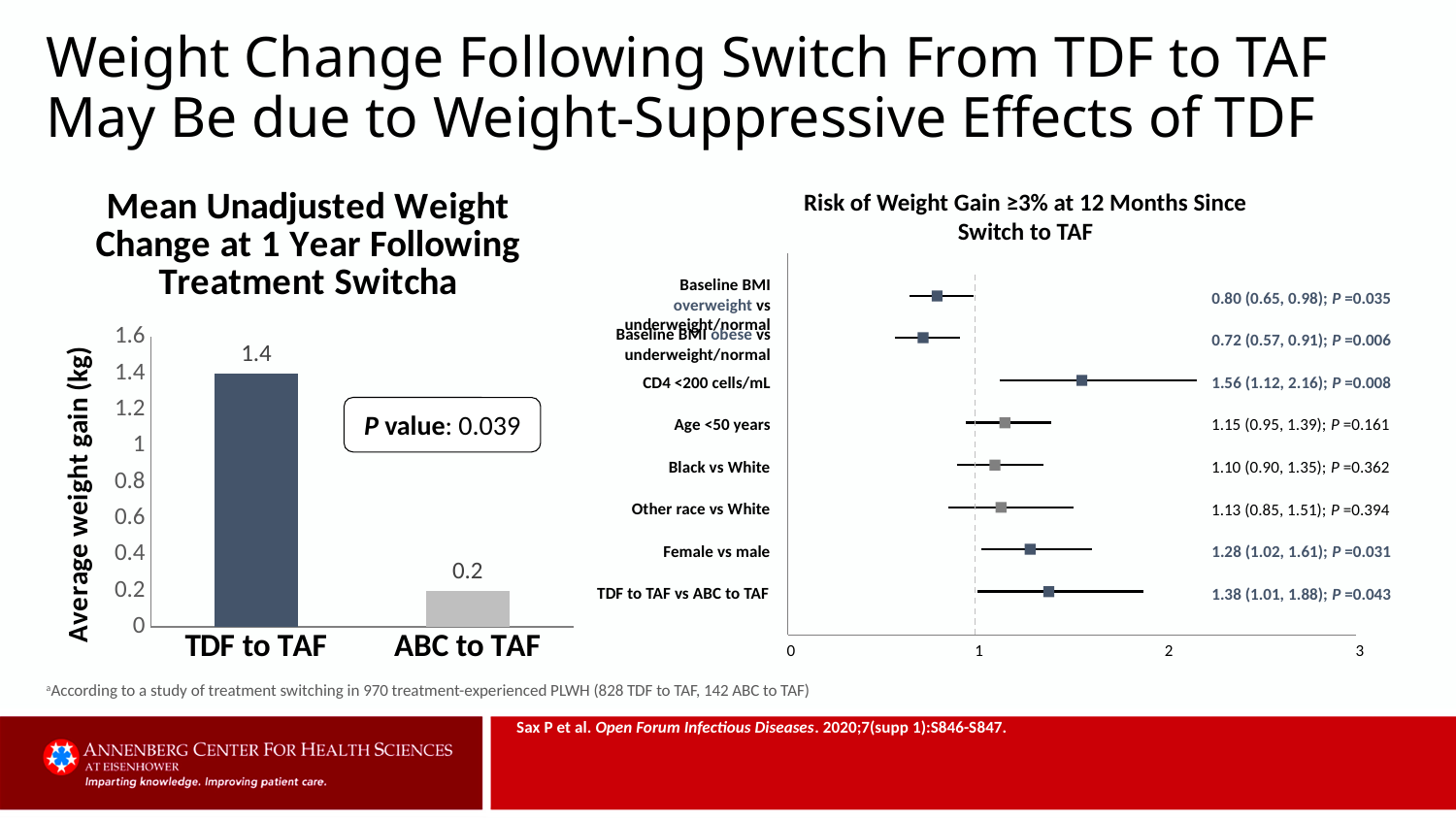
How many comparisons are plotted in the right chart (Risk of Weight Gain ≥3% at 12 Months Since Switch to TAF)? 8 In the right chart (Risk of Weight Gain ≥3% at 12 Months Since Switch to TAF), which comparison has the highest point estimate? CD4 <200 cells/mL In the left chart (Mean Unadjusted Weight Change at 1 Year Following Treatment Switch), what P value is shown? 0.039 In the left chart (Mean Unadjusted Weight Change at 1 Year Following Treatment Switch), which group has the higher average weight gain? TDF to TAF In the left chart (Mean Unadjusted Weight Change at 1 Year Following Treatment Switch), what is the difference in average weight gain between TDF to TAF and ABC to TAF? 1.2 In the right chart (Risk of Weight Gain ≥3% at 12 Months Since Switch to TAF), what is the estimate for Female vs male? 1.28 (1.02, 1.61); P =0.031 In the left chart (Mean Unadjusted Weight Change at 1 Year Following Treatment Switch), what is the y-axis label? Average weight gain (kg) In the left chart (Mean Unadjusted Weight Change at 1 Year Following Treatment Switch), what is the average weight gain for TDF to TAF? 1.4 In the right chart (Risk of Weight Gain ≥3% at 12 Months Since Switch to TAF), what is the estimate for CD4 <200 cells/mL? 1.56 (1.12, 2.16); P =0.008 In the right chart (Risk of Weight Gain ≥3% at 12 Months Since Switch to TAF), which comparison has the lowest point estimate? Baseline BMI obese vs underweight/normal What kind of chart is the left chart (Mean Unadjusted Weight Change at 1 Year Following Treatment Switch)? Bar chart In the left chart (Mean Unadjusted Weight Change at 1 Year Following Treatment Switch), what is the average weight gain for ABC to TAF? 0.2